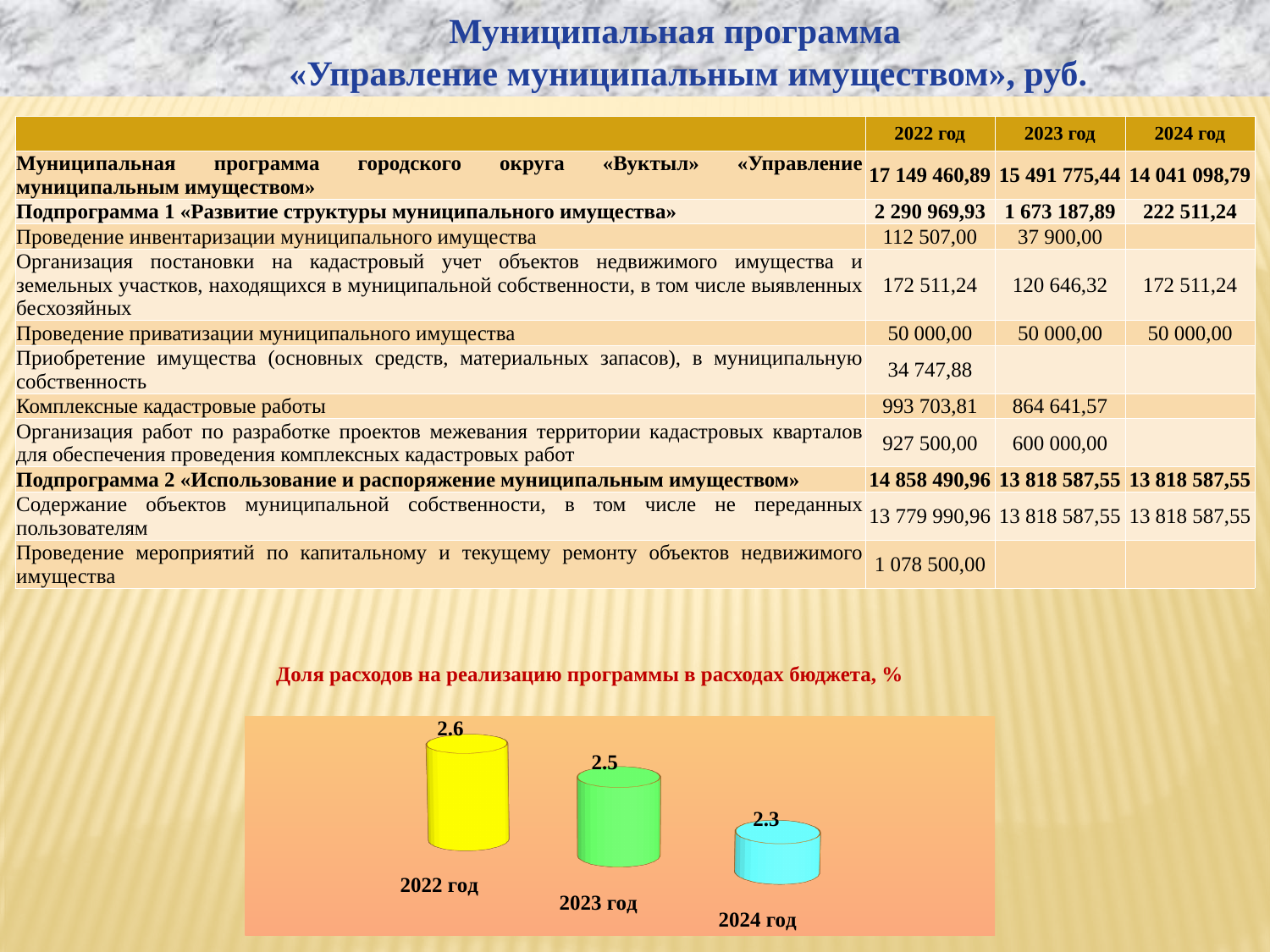
What is the difference between the values for 2022 год and 2024 год in the chart? 0.3 What is the value shown for 2023 год in the chart? 2.5 Which year has the highest value in the chart? 2022 год What is the difference between the values for 2023 год and 2024 год in the chart? 0.2 Which is larger in the chart: the value for 2022 год or the value for 2023 год? 2022 год What is the title of the chart at the bottom of the slide? Доля расходов на реализацию программы в расходах бюджета, % Do the values in the chart rise or fall from 2022 год to 2024 год? Fall How many years are plotted in the chart? 3 What is the value shown for 2024 год in the chart? 2.3 Which year has the lowest value in the chart? 2024 год What is the value shown for 2022 год in the chart? 2.6 What kind of chart is shown at the bottom of the slide? Bar chart